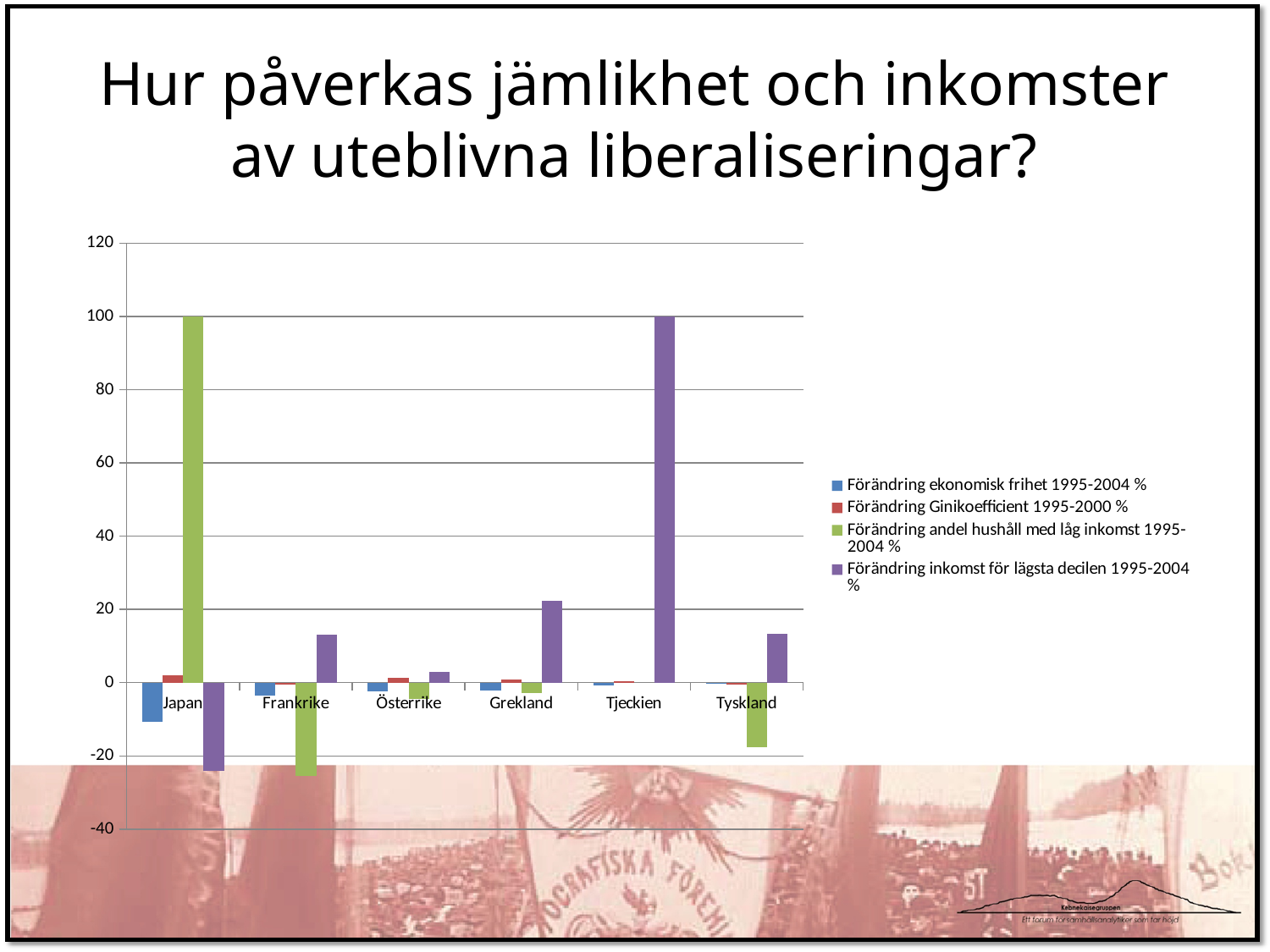
Which country has the highest value for 'Förändring inkomst för lägsta decilen 1995-2004 %'? Tjeckien Is the value for 'Förändring inkomst för lägsta decilen 1995-2004 %' in Japan greater or less than -20? less Which country has the lowest value for 'Förändring inkomst för lägsta decilen 1995-2004 %'? Japan How many series does the chart's legend list? 4 How many countries are shown on the x axis of the chart? 6 Which is larger: the value for 'Förändring inkomst för lägsta decilen 1995-2004 %' in Grekland or in Tyskland? Grekland Which country has the lowest value for 'Förändring andel hushåll med låg inkomst 1995-2004 %'? Frankrike Which colour represents 'Förändring Ginikoefficient 1995-2000 %' in the chart? red Is the value for 'Förändring inkomst för lägsta decilen 1995-2004 %' in Grekland greater or less than 20? greater What kind of chart is shown on the slide? bar chart Is the value for 'Förändring andel hushåll med låg inkomst 1995-2004 %' in Japan greater or less than 80? greater Which country has the highest value for 'Förändring andel hushåll med låg inkomst 1995-2004 %'? Japan